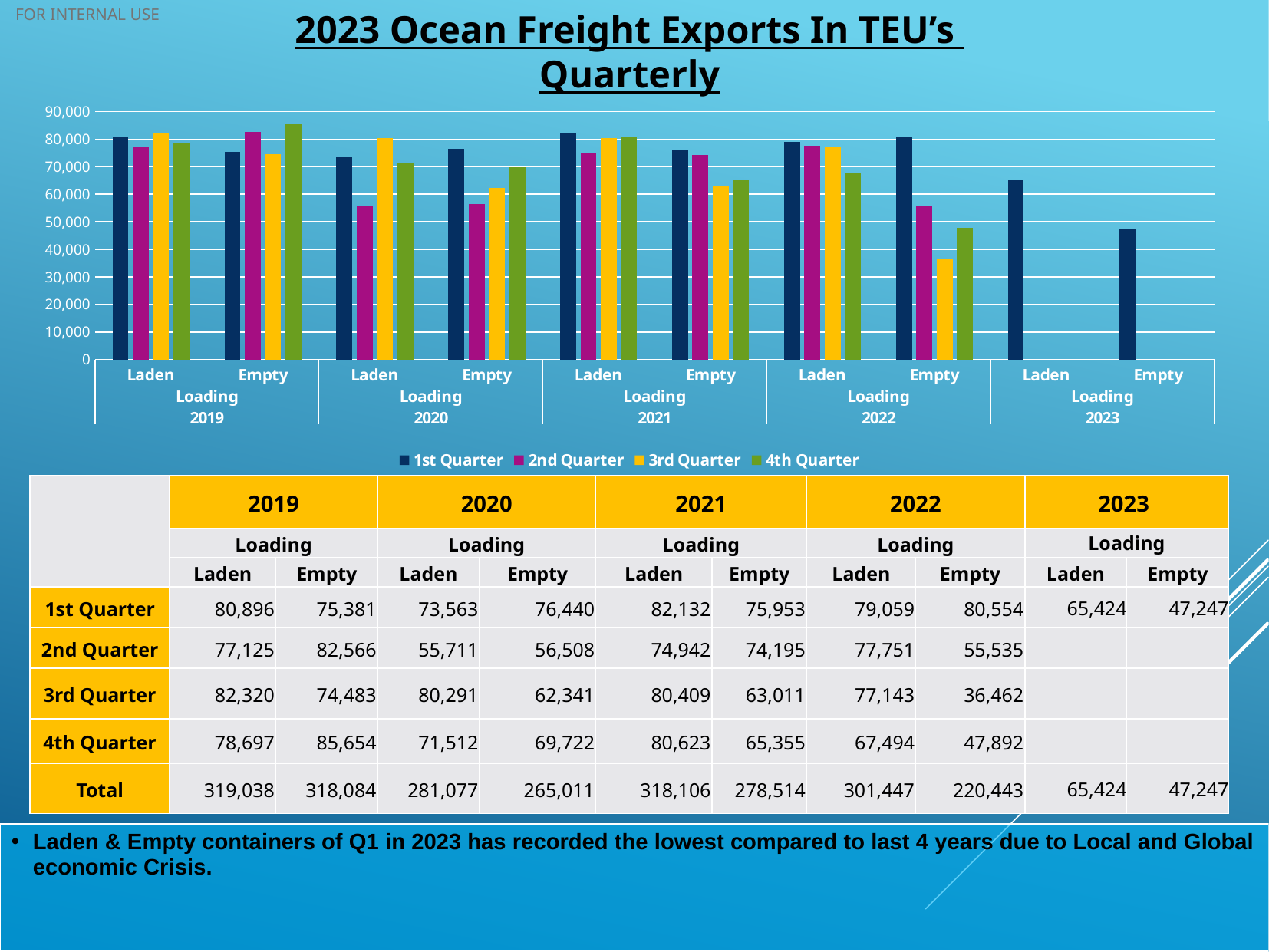
What is the difference between the 1st Quarter Laden value for 2019 and the 1st Quarter Laden value for 2023? 15,472 Which is larger: the 1st Quarter Laden value for 2021 or the 1st Quarter Empty value for 2021? 1st Quarter Laden 2021 Which bar in the chart has the highest value? 4th Quarter, Empty loading 2019 How many series does the chart legend list? 4 How many Laden/Empty category groups are plotted along the x axis of the chart? 10 Do the Laden loading values for 2022 rise or fall from the 1st Quarter to the 4th Quarter? Fall What is the 1st Quarter value for Laden loading in 2023? 65,424 Which bar in the chart has the lowest value? 3rd Quarter, Empty loading 2022 Is the 1st Quarter value for Empty loading in 2023 greater or less than 50,000? less What type of chart is shown on the slide? Bar chart What is the 4th Quarter value for Empty loading in 2019? 85,654 What is the 3rd Quarter value for Empty loading in 2022? 36,462